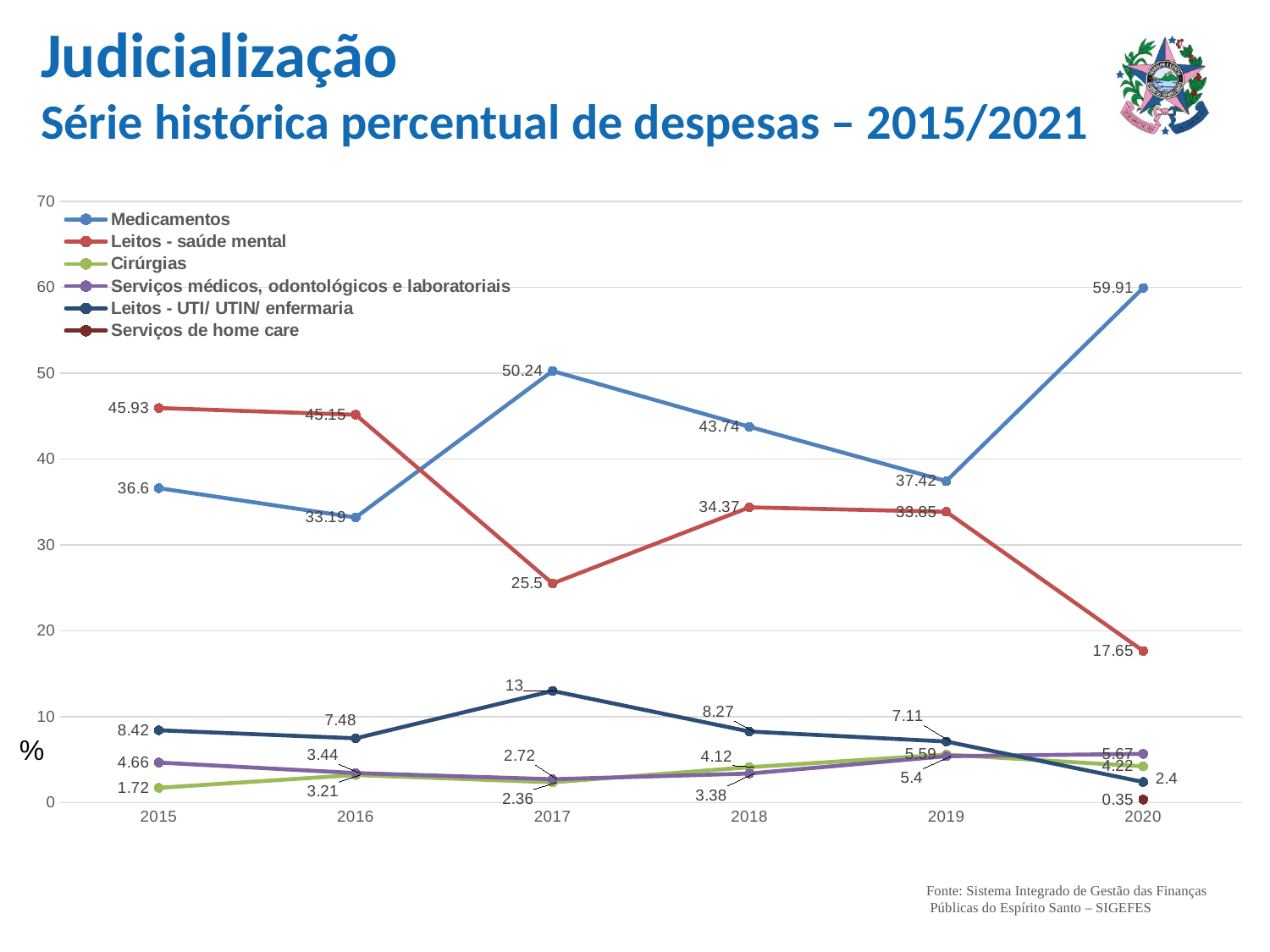
What is the value for Medicamentos in 2020? 59.91 What kind of chart is shown on the slide? line chart What is the value for Leitos - UTI/ UTIN/ enfermaria in 2017? 13 In which year is Medicamentos at its highest? 2020 In which year is Leitos - saúde mental at its lowest? 2020 What is the value for Serviços de home care in 2020? 0.35 Does the Leitos - saúde mental line rise or fall from 2019 to 2020? fall What is the difference between the Medicamentos values for 2020 and 2019? 22.49 In 2015, which is larger: Medicamentos or Leitos - saúde mental? Leitos - saúde mental What is the value for Leitos - saúde mental in 2017? 25.5 How many years are plotted along the x axis? 6 How many series does the legend list? 6